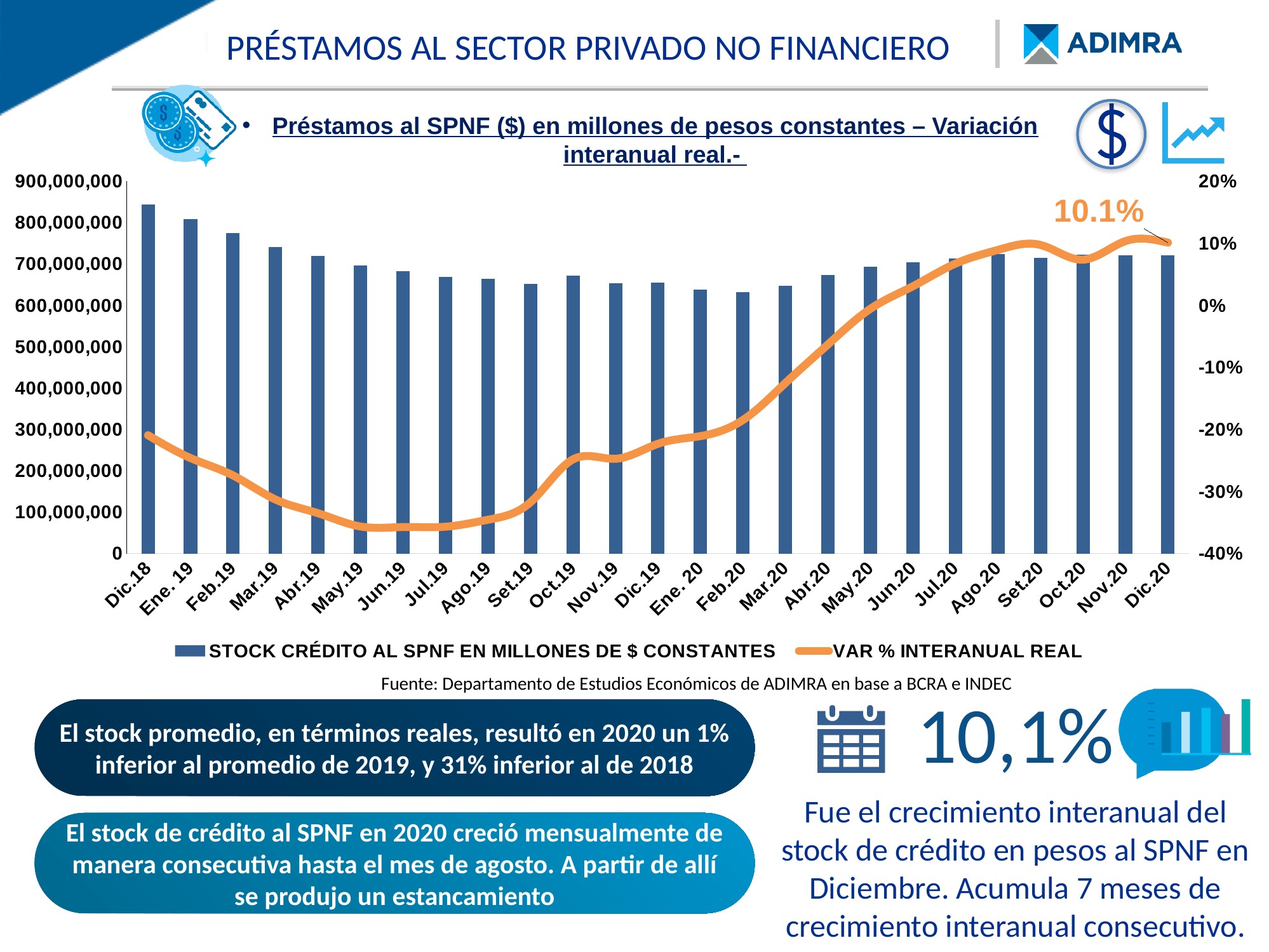
Is the stock bar for Dic.18 greater or less than 800,000,000? greater Which has the larger stock bar, Dic.18 or Dic.20? Dic.18 Which month has the highest bar for STOCK CRÉDITO AL SPNF EN MILLONES DE $ CONSTANTES? Dic.18 Which month has the higher VAR % INTERANUAL REAL value, Dic.18 or Dic.20? Dic.20 How many series does the legend list? 2 Is the stock bar for Feb.20 greater or less than 700,000,000? less What is the VAR % INTERANUAL REAL value labelled for Dic.20? 10.1% Does the VAR % INTERANUAL REAL line rise or fall from Jun.19 to Set.20? Rise What kind of chart is shown on the slide? Combined bar and line chart Is the VAR % INTERANUAL REAL value for Dic.20 greater or less than 0%? greater How many months are shown on the x axis? 25